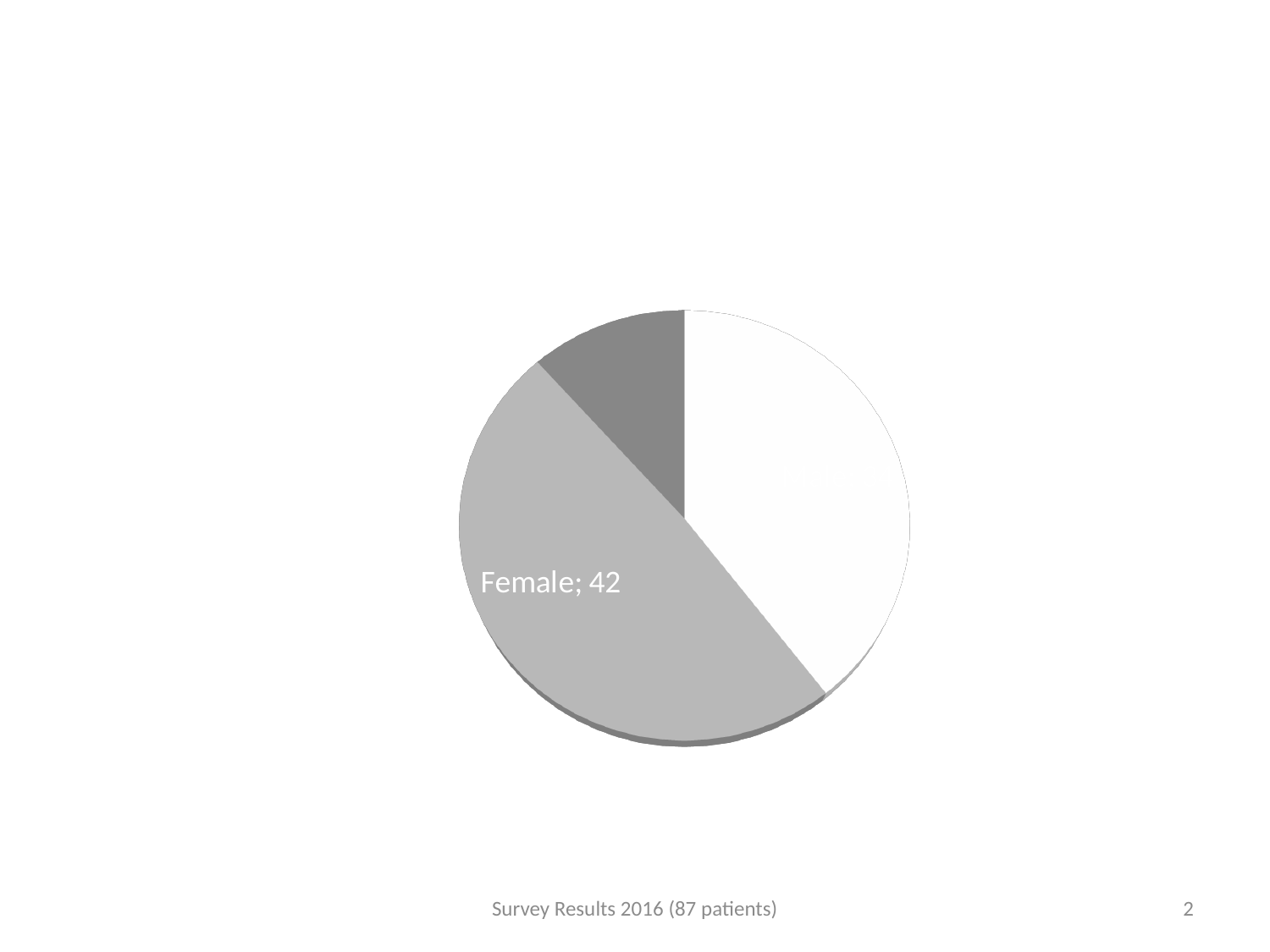
What is the value shown for the Female slice of the pie chart? 42 What colour is the Female slice of the pie chart? light gray What text appears in the footer below the pie chart? Survey Results 2016 (87 patients) Which slice of the pie chart is the smallest: the white slice, the light gray Female slice, or the dark gray slice? the dark gray slice Which is larger in the pie chart: the Female slice or the white slice? Female How many slices does the pie chart have? 3 What kind of chart is shown on the slide? pie chart Which slice of the pie chart is the largest? Female